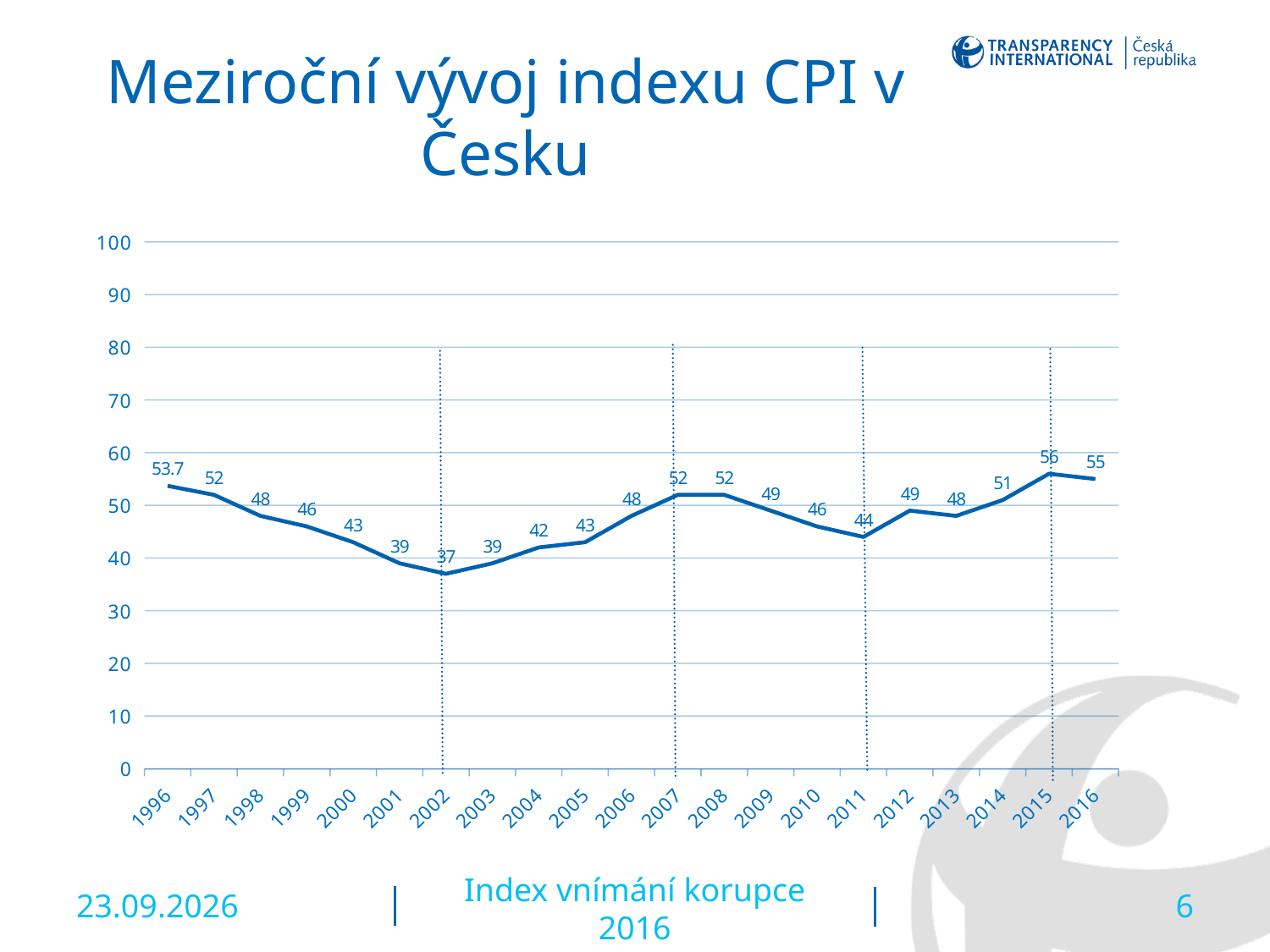
What type of chart is shown on the slide? line chart What is the CPI value for 2002? 37 What is the title of the chart slide? Meziroční vývoj indexu CPI v Česku Which year has the highest CPI value? 2015 What is the difference between the CPI values for 2015 and 2002? 19 Which year has a higher CPI value, 2011 or 2012? 2012 What is the CPI value for 1996? 53.7 How many years are plotted on the x axis? 21 Is the CPI value for 2005 greater or less than 50? less Do the CPI values rise or fall from 1996 to 2002? fall Which year has the lowest CPI value? 2002 What is the CPI value for 2016? 55